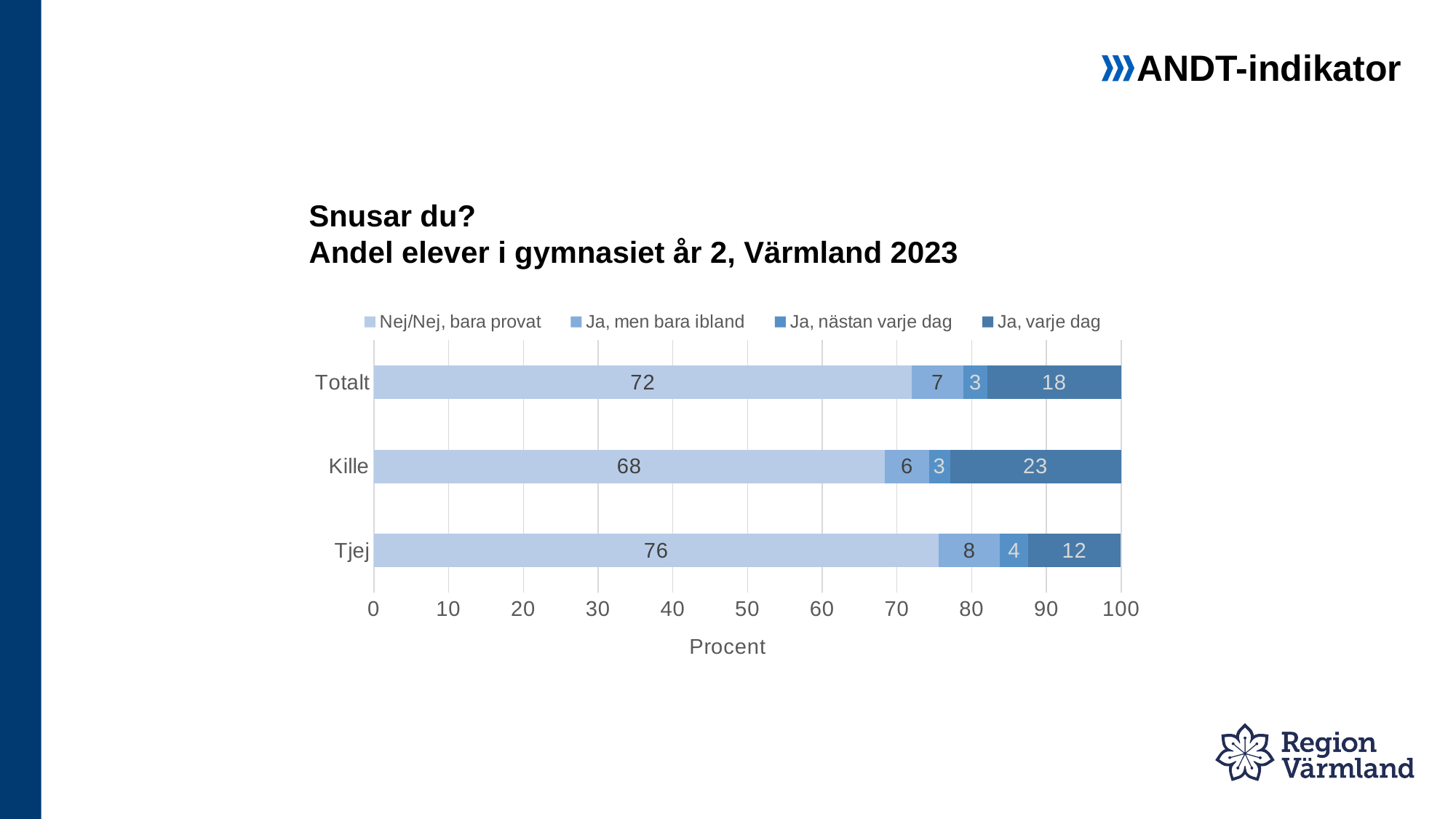
What is the difference between the "Ja, varje dag" values for Kille and Tjej? 11 How many series does the legend list? 4 What is the value for "Ja, men bara ibland" for Tjej? 8 Which category has the lowest value for "Nej/Nej, bara provat"? Kille Which category has the highest value for "Ja, varje dag"? Kille What is the value for "Ja, nästan varje dag" for Tjej? 4 What is the value for "Nej/Nej, bara provat" for Totalt? 72 Which is larger: the "Nej/Nej, bara provat" value for Tjej or for Totalt? Tjej What is the value for "Ja, varje dag" for Kille? 23 What is the total of the stacked bar for Totalt? 100 What kind of chart is shown? Stacked bar chart How many categories are shown on the y axis? 3